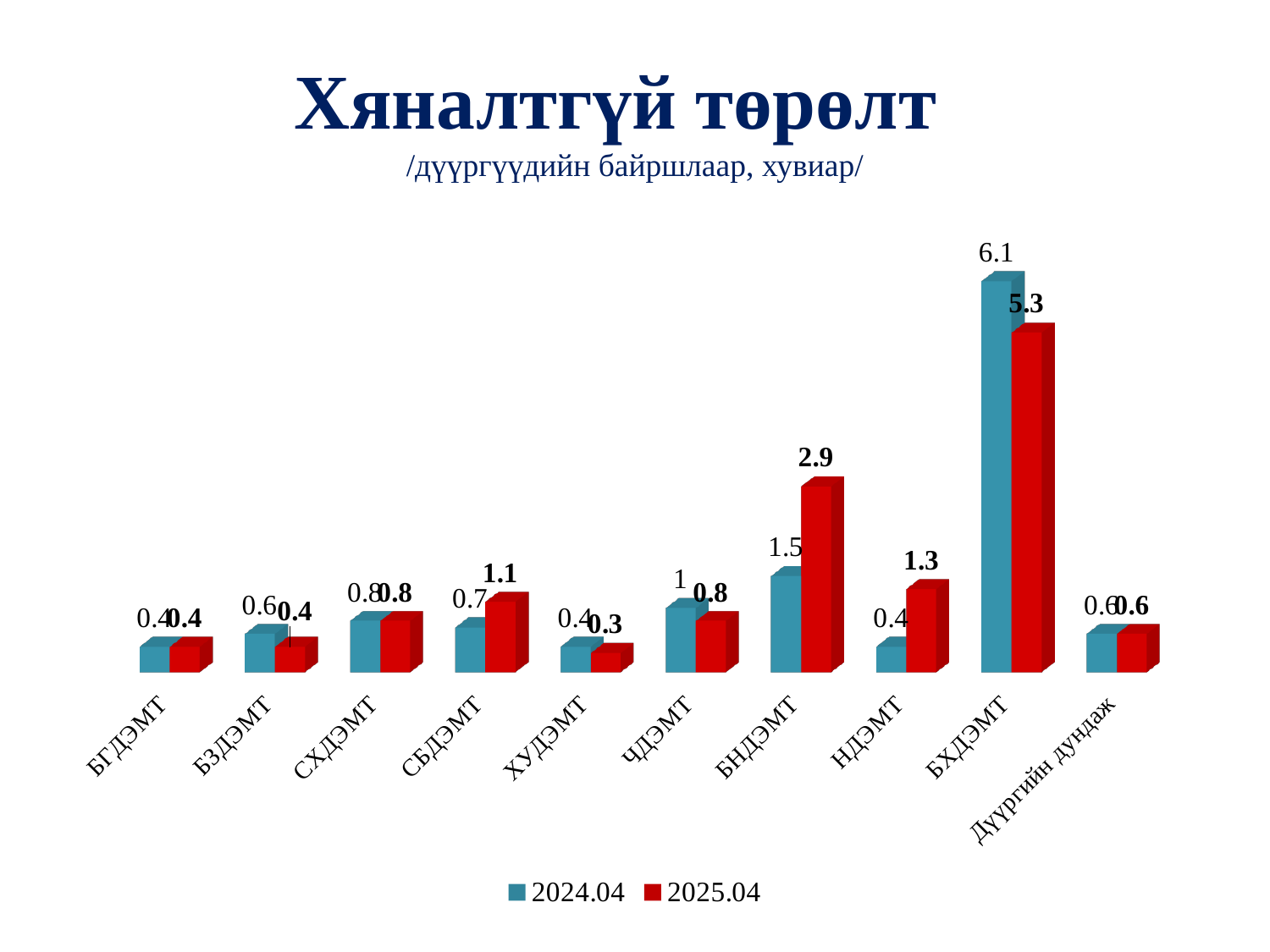
How many series does the legend list? 2 Which category has the highest value in the 2025.04 series? БХДЭМТ Which category has the lowest value in the 2025.04 series? ХУДЭМТ For ЧДЭМТ, which series has the larger value, 2024.04 or 2025.04? 2024.04 How many categories are shown on the x axis? 10 What is the value for БХДЭМТ in the 2024.04 series? 6.1 What is the difference between the 2024.04 and 2025.04 values for БХДЭМТ? 0.8 What is the value for БНДЭМТ in the 2025.04 series? 2.9 What is the value for НДЭМТ in the 2025.04 series? 1.3 What is the difference between the 2025.04 and 2024.04 values for БНДЭМТ? 1.4 What is the value for СБДЭМТ in the 2024.04 series? 0.7 What type of chart is shown on the slide? Bar chart